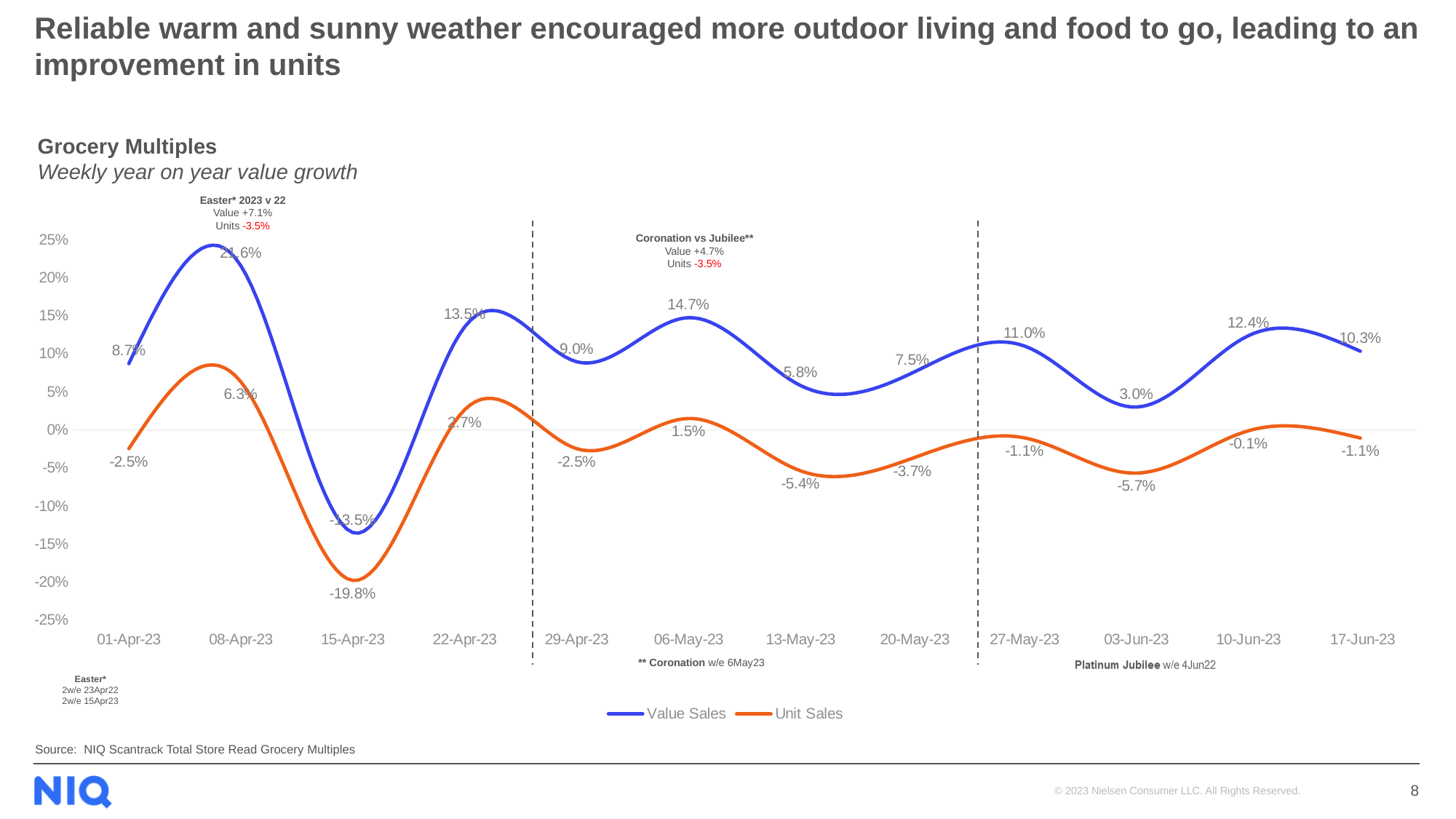
What is the Unit Sales growth for the week 03-Jun-23? -5.7% Does Value Sales growth rise or fall from 27-May-23 to 03-Jun-23? Fall What kind of chart is shown on the slide? Line chart What is the Unit Sales growth for the week 15-Apr-23? -19.8% What is the Value Sales growth for the week 06-May-23? 14.7% How many weekly dates are plotted along the x axis? 12 In which week is Unit Sales growth lowest? 15-Apr-23 In which week is Value Sales growth highest? 08-Apr-23 How many series does the legend list? 2 Which week has higher Value Sales growth, 10-Jun-23 or 17-Jun-23? 10-Jun-23 What is the Value Sales growth for the week 27-May-23? 11.0% What is the difference between Value Sales growth in 06-May-23 and 13-May-23? 8.9 percentage points